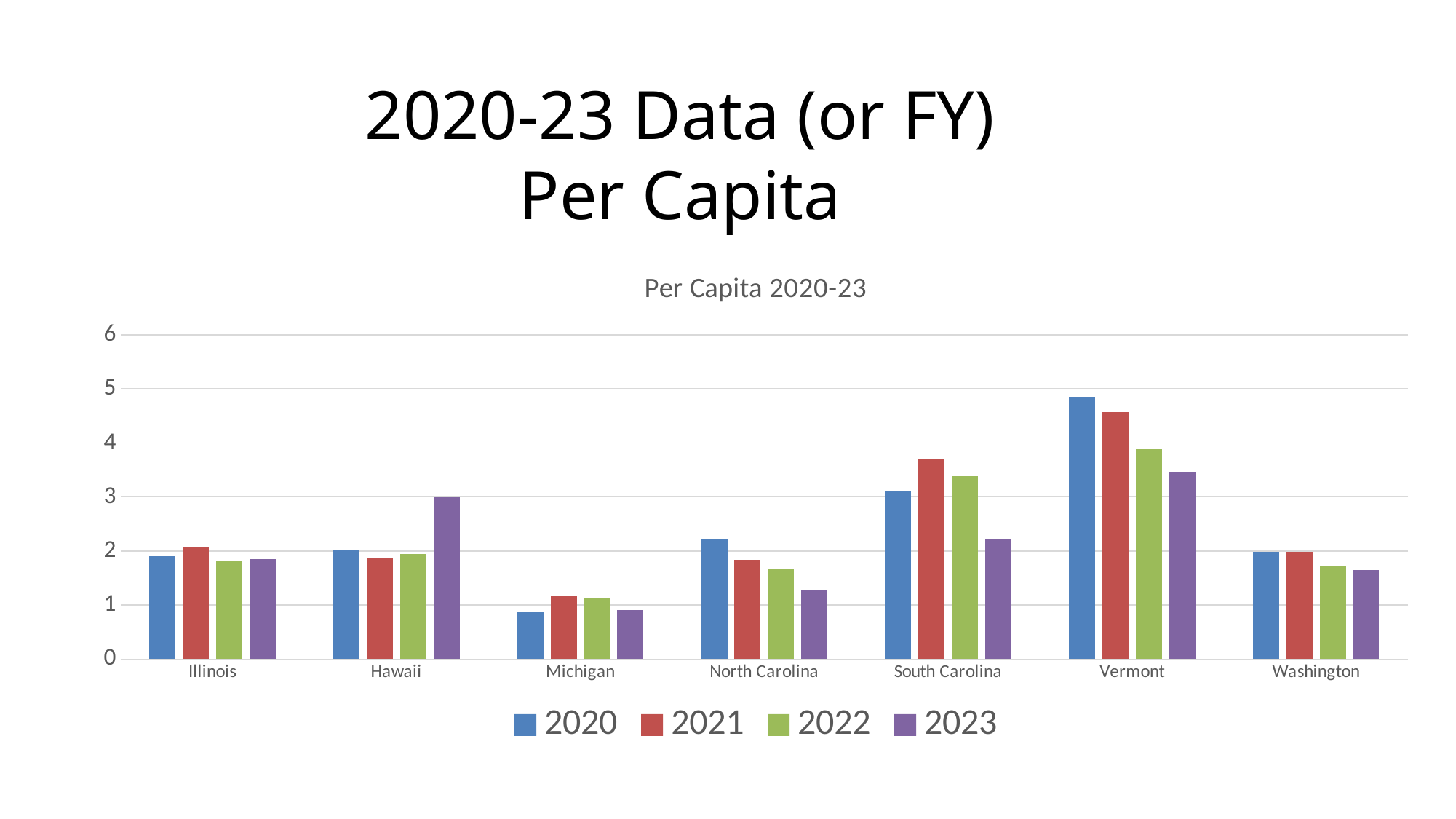
Which state has the lowest value for 2020? Michigan Is the value for Michigan in 2020 greater or less than 1? less Which is larger for 2023: Hawaii or Illinois? Hawaii Is the value for Vermont in 2020 greater or less than 4? greater For South Carolina, which is larger: the 2020 value or the 2021 value? 2021 What is the title of the chart? Per Capita 2020-23 How many series does the legend list? 4 Is the value for Hawaii in 2023 greater or less than 2? greater Do Vermont's values rise or fall from 2020 to 2023? fall What kind of chart is shown on the slide? Bar chart How many states are shown on the x axis? 7 Which state has the highest value for 2020? Vermont